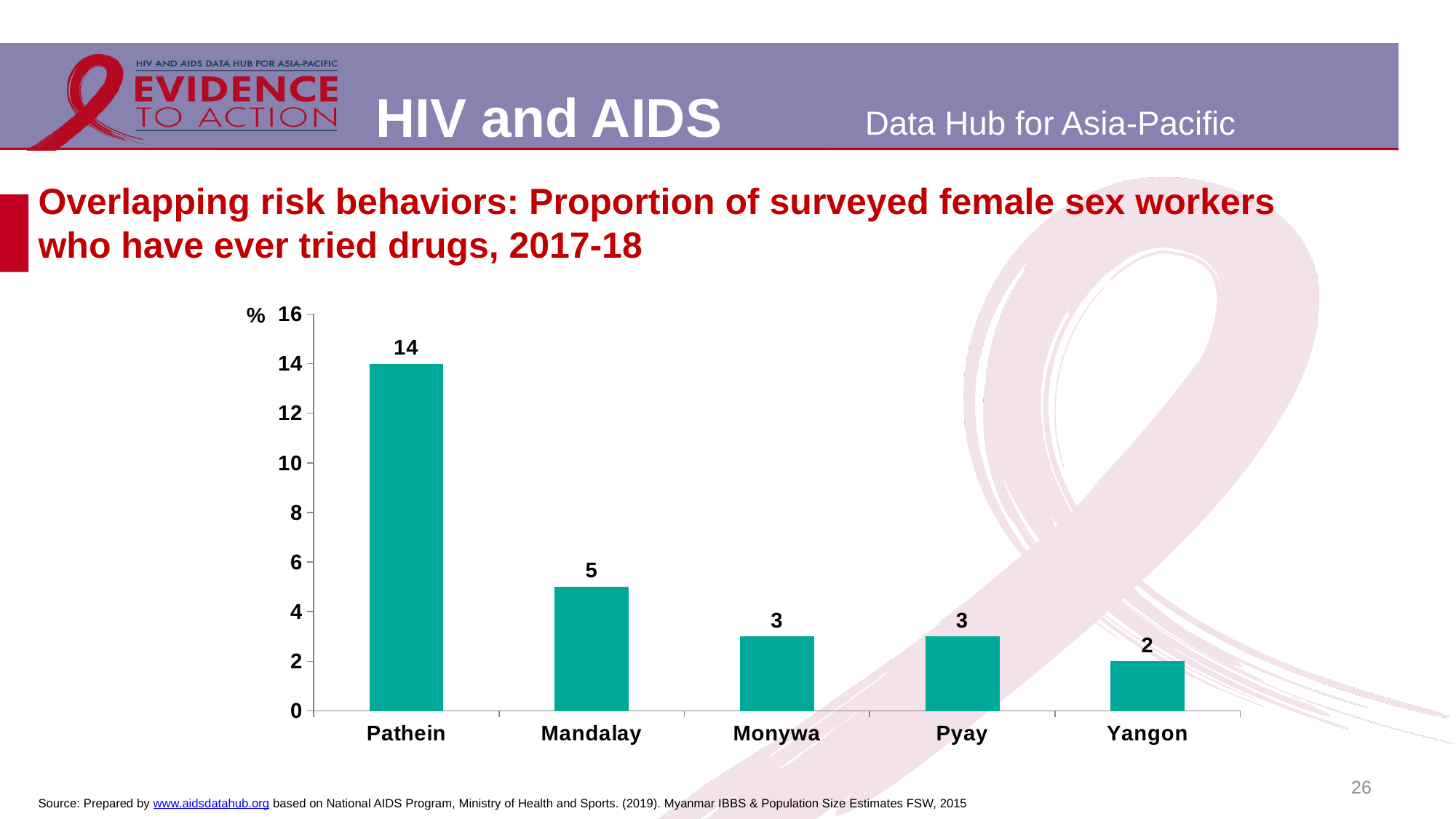
Is the value for Pathein greater or less than 10? greater How many cities are shown on the chart? 5 What is the value for Pathein? 14 What is the difference between the values for Monywa and Yangon? 1 What kind of chart is shown on the slide? Bar chart What is the value for Yangon? 2 What is the value for Mandalay? 5 Which city has the lowest value? Yangon What is the difference between the values for Pathein and Mandalay? 9 Which city has the highest proportion of surveyed female sex workers who have ever tried drugs? Pathein Which is larger, the value for Mandalay or the value for Pyay? Mandalay What unit is shown on the vertical axis of the chart? %